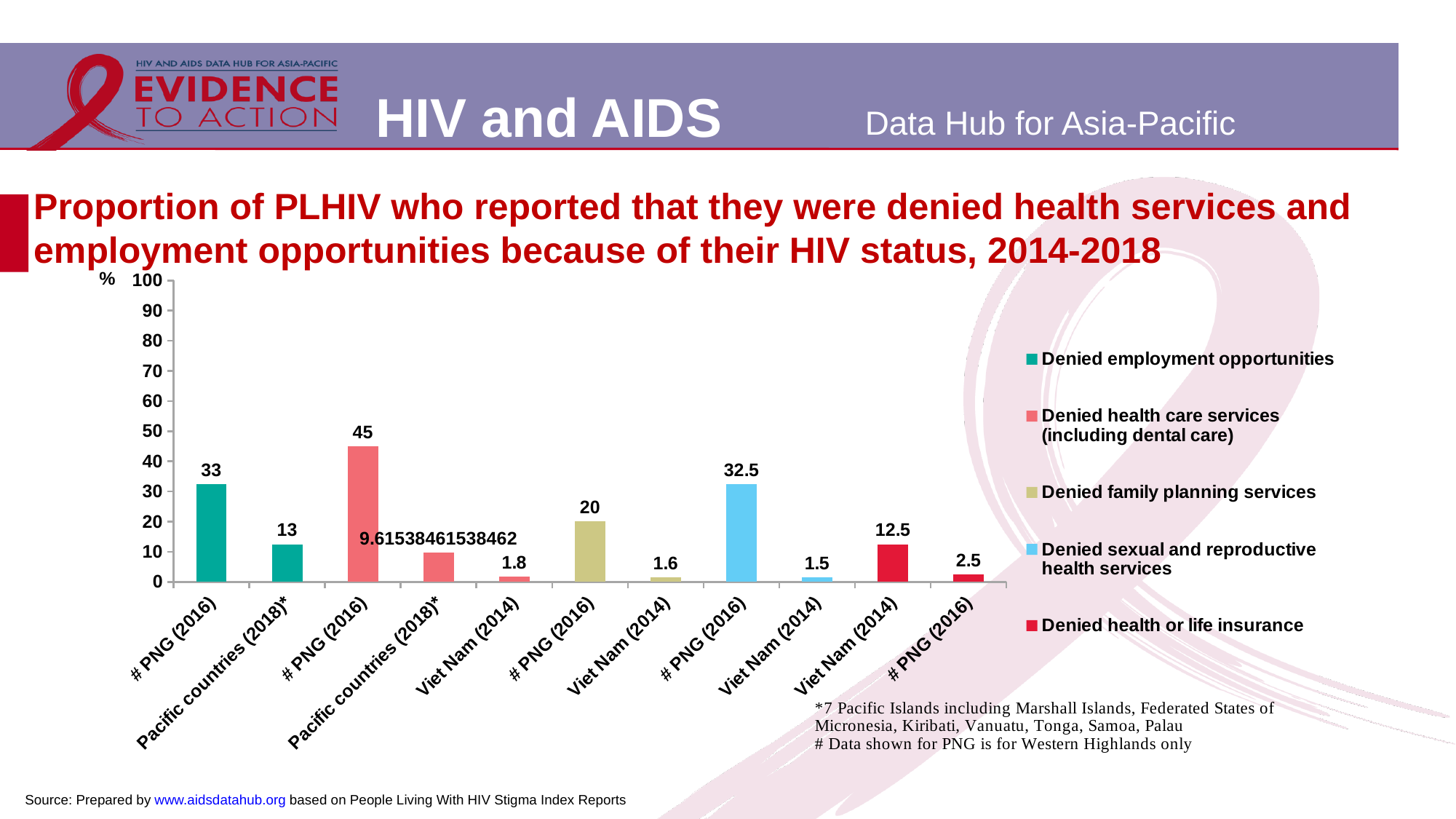
Is the 'Denied health care services (including dental care)' value for # PNG (2016) greater or less than 40? greater Which bar has the highest value in the chart? # PNG (2016), Denied health care services (including dental care) How many bars are plotted in the chart? 11 Which bar has the lowest value in the chart? Viet Nam (2014), Denied sexual and reproductive health services How many series does the legend list? 5 What is the value for Viet Nam (2014) in the 'Denied health or life insurance' series? 12.5 What is the value for Pacific countries (2018)* in the 'Denied health care services (including dental care)' series? 9.61538461538462 What is the value for # PNG (2016) in the 'Denied sexual and reproductive health services' series? 32.5 What is the value for # PNG (2016) in the 'Denied employment opportunities' series? 33 Which is larger: the 'Denied family planning services' value for # PNG (2016) or the 'Denied health or life insurance' value for Viet Nam (2014)? # PNG (2016), Denied family planning services What is the difference between the 'Denied employment opportunities' values for # PNG (2016) and Pacific countries (2018)*? 20 What kind of chart is shown on the slide? bar chart